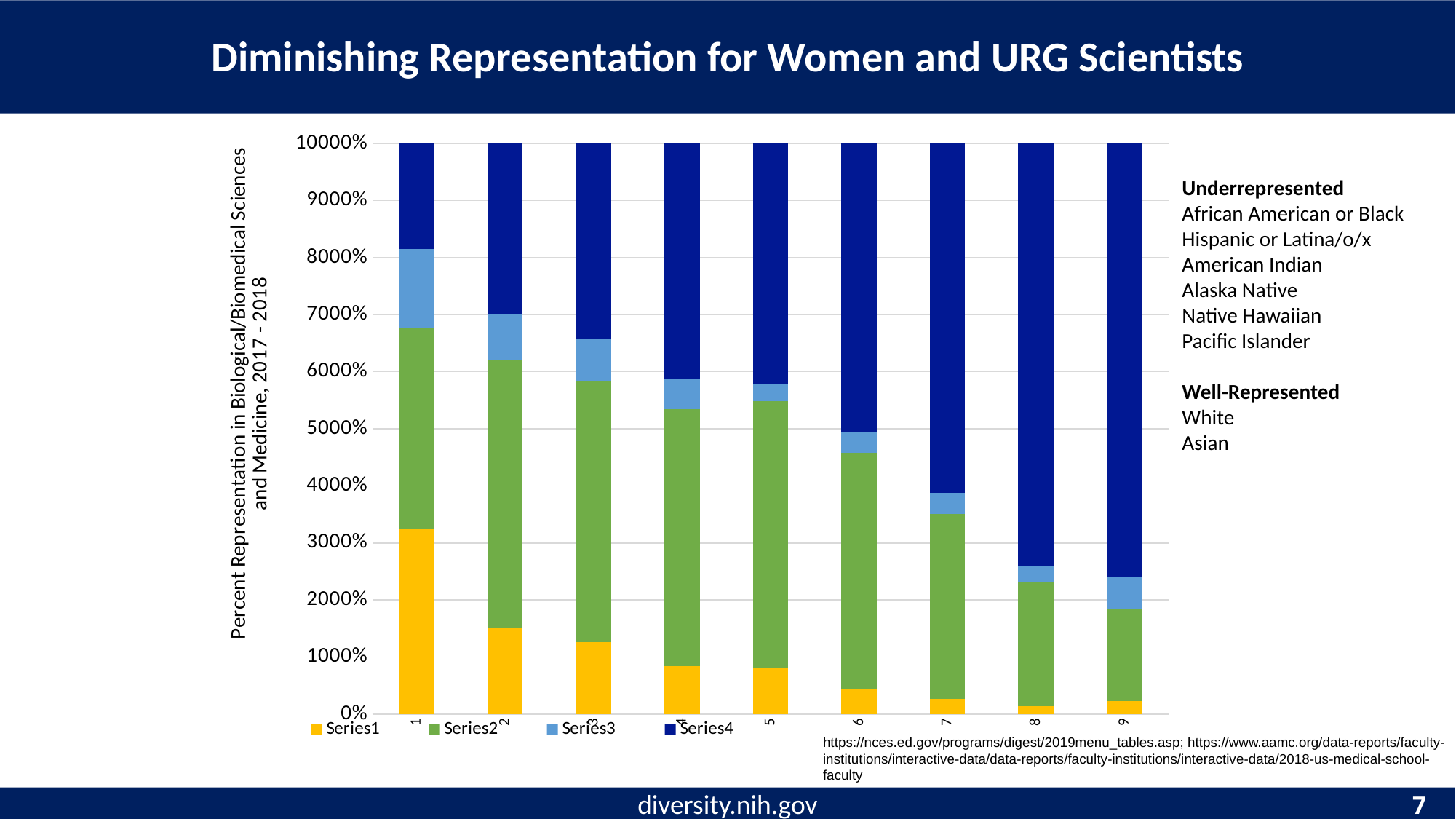
Which is larger, the Series1 segment for category 3 or for category 7? Category 3 How many categories are shown along the x axis of the chart? 9 How many series does the chart's legend list? 4 What is the total height of the stacked bar for category 1? 10000% Is the Series1 value for category 2 greater or less than 1000%? greater Is the Series1 value for category 6 greater or less than 1000%? less Which category has the smallest Series4 segment? 1 What is the title of the chart's vertical axis? Percent Representation in Biological/Biomedical Sciences and Medicine, 2017 - 2018 Does the Series1 segment generally rise or fall from category 1 to category 9? Fall Which category has the largest Series1 segment? 1 Is the Series1 value for category 1 greater or less than 3000%? greater What kind of chart is shown on the slide? Stacked bar chart